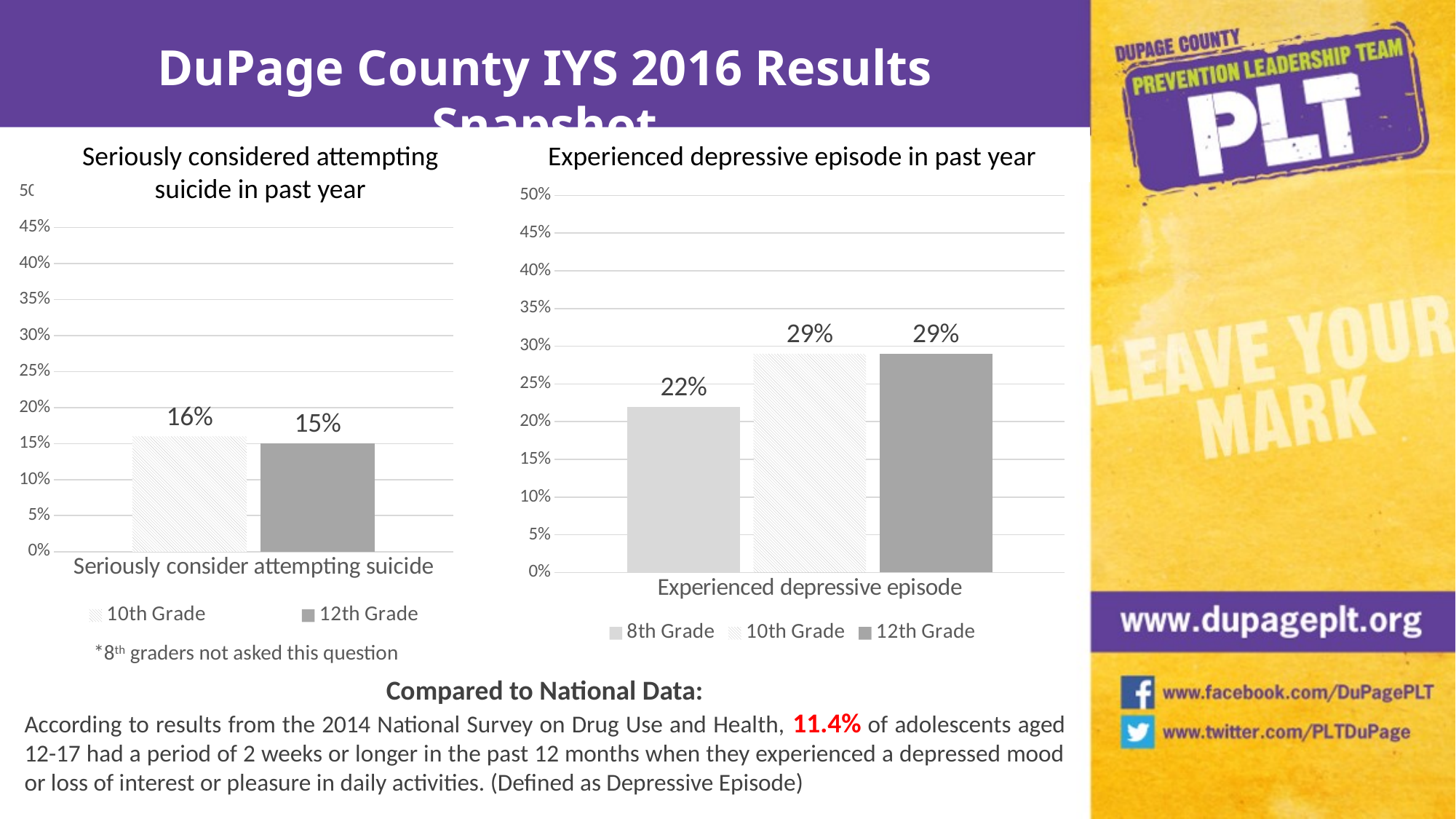
In the 'Seriously considered attempting suicide in past year' chart, what is the difference between the 10th Grade and 12th Grade values? 1% In the 'Experienced depressive episode in past year' chart, is the value for 8th Grade greater or less than 25%? less In the 'Experienced depressive episode in past year' chart, what is the value for 10th Grade? 29% In the 'Seriously considered attempting suicide in past year' chart, how many series does the legend list? 2 In the 'Experienced depressive episode in past year' chart, which grade has the lowest value? 8th Grade In the 'Seriously considered attempting suicide in past year' chart, what is the value for 12th Grade? 15% In the 'Seriously considered attempting suicide in past year' chart, what is the value for 10th Grade? 16% In the 'Experienced depressive episode in past year' chart, what is the value for 8th Grade? 22% In the 'Experienced depressive episode in past year' chart, what is the difference between the 12th Grade and 8th Grade values? 7% In the 'Experienced depressive episode in past year' chart, which series is shown with the darkest grey bar? 12th Grade In the 'Experienced depressive episode in past year' chart, how many series does the legend list? 3 What kind of chart is the 'Experienced depressive episode in past year' chart? bar chart